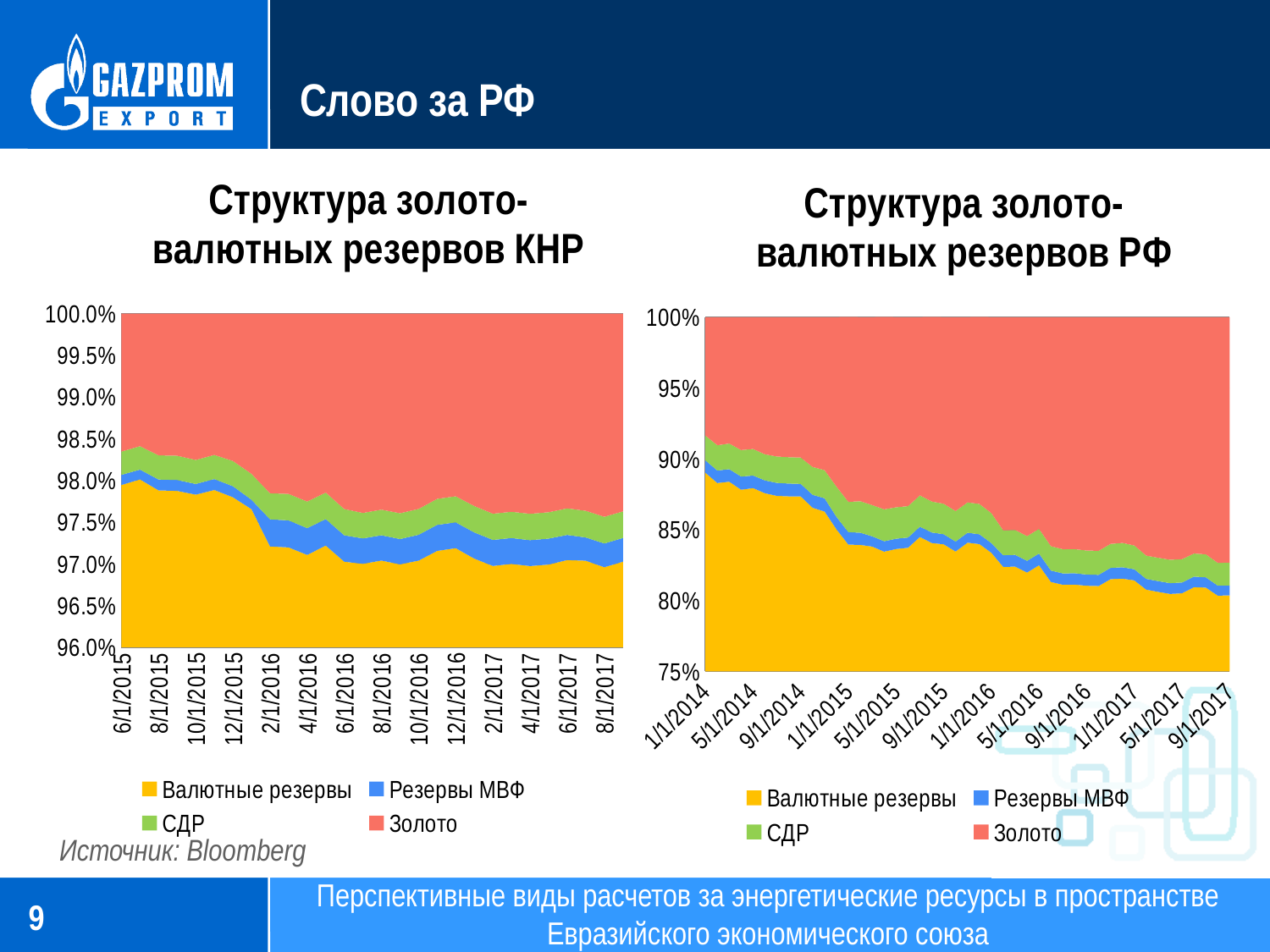
How many series does the legend of the left chart ('Структура золото-валютных резервов КНР') list? 4 In the left chart ('Структура золото-валютных резервов КНР'), does the share of Валютные резервы rise or fall from 6/1/2015 to 8/1/2017? Fall Which series is shown in red in the right chart ('Структура золото-валютных резервов РФ')? Золото In the right chart ('Структура золото-валютных резервов РФ'), is the value for Валютные резервы at 9/1/2017 greater or less than 85%? less In the right chart ('Структура золото-валютных резервов РФ'), is the value for Валютные резервы at 1/1/2014 greater or less than 85%? greater What source is cited for the charts on the slide? Bloomberg How many series does the legend of the right chart ('Структура золото-валютных резервов РФ') list? 4 What kind of chart is the right chart, 'Структура золото-валютных резервов РФ'? Stacked area chart What kind of chart is the left chart, 'Структура золото-валютных резервов КНР'? Stacked area chart In the left chart ('Структура золото-валютных резервов КНР'), is the value for Валютные резервы at 8/1/2017 greater or less than 97.5%? less In the right chart ('Структура золото-валютных резервов РФ'), does the share of Валютные резервы rise or fall from 1/1/2014 to 9/1/2017? Fall